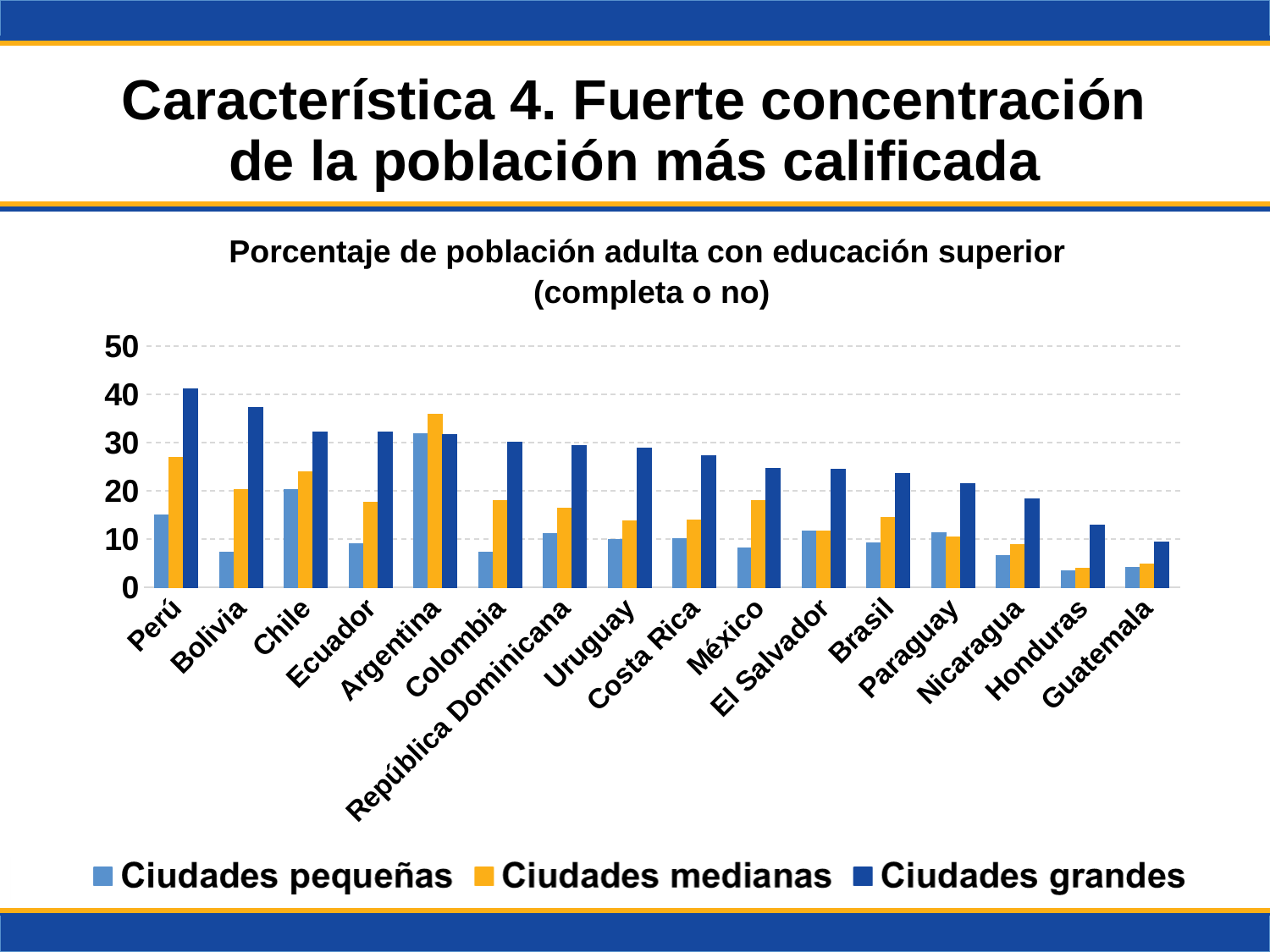
What kind of chart is shown on the slide? bar chart Do the values for Ciudades grandes generally rise or fall from left to right across the countries? fall How many series does the legend list? 3 Which country has the lowest value for Ciudades grandes? Guatemala Is the value for Ciudades grandes in Bolivia greater or less than 30? greater Which country has the highest value for Ciudades pequeñas? Argentina For Bolivia, which is larger: Ciudades medianas or Ciudades grandes? Ciudades grandes Is the value for Ciudades grandes in Costa Rica greater or less than 30? less Which country has the highest value for Ciudades medianas? Argentina Which country has the highest value for Ciudades grandes? Perú How many countries are shown on the x axis? 16 Is the value for Ciudades pequeñas in Bolivia greater or less than 10? less